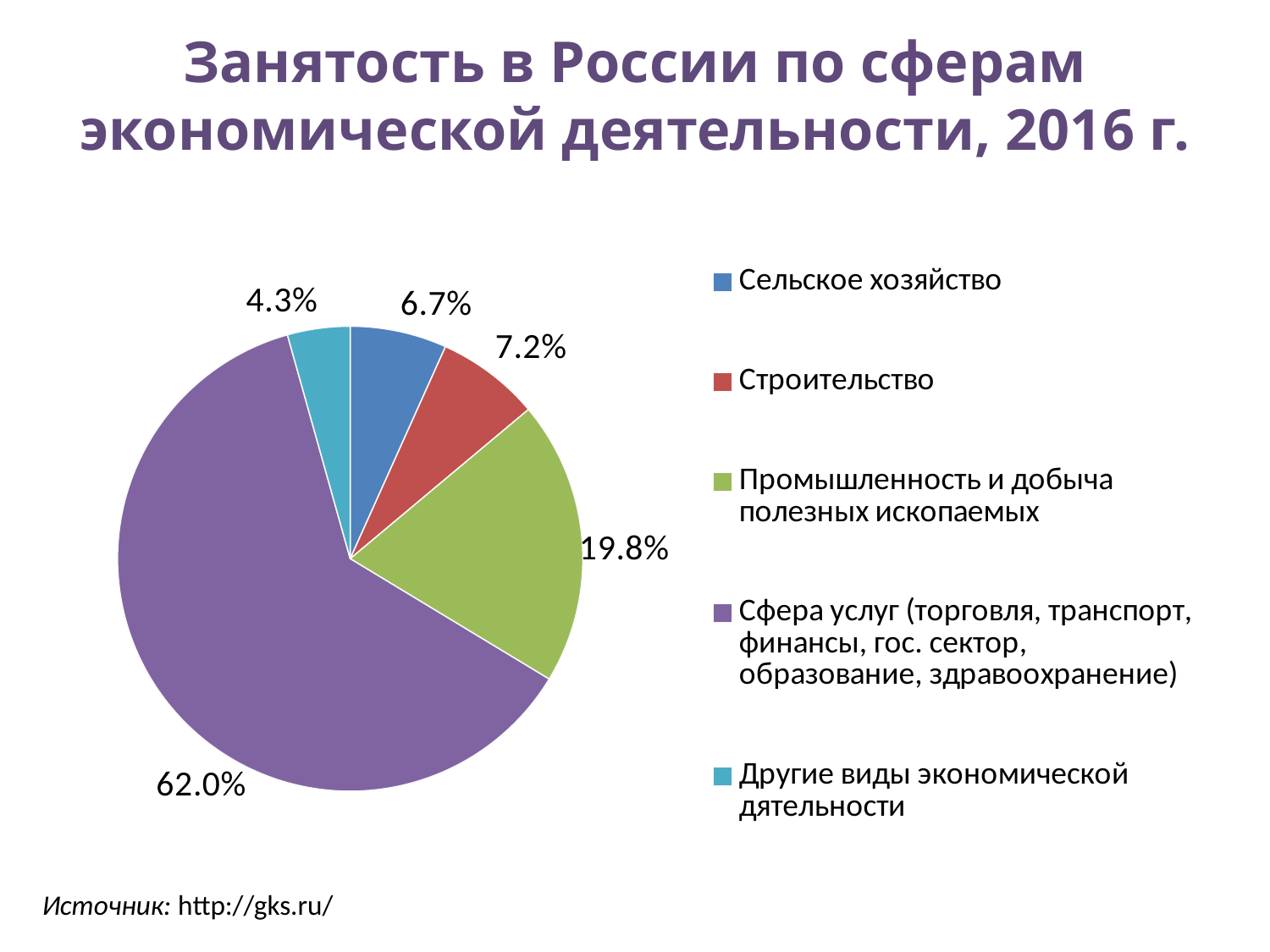
What is the difference in percentage points between Сфера услуг and Промышленность и добыча полезных ископаемых? 42.2 What share of employment does Строительство have? 7.2% What share of employment does Промышленность и добыча полезных ископаемых have? 19.8% How many sectors are shown in the pie chart? 5 What share of employment does Другие виды экономической дятельности have? 4.3% What share of employment does Сфера услуг have? 62.0% Which sector has the smallest share of employment? Другие виды экономической дятельности What is the title of the chart? Занятость в России по сферам экономической деятельности, 2016 г. Which has a larger share: Строительство or Сельское хозяйство? Строительство Which sector has the largest share of employment? Сфера услуг (торговля, транспорт, финансы, гос. сектор, образование, здравоохранение) What kind of chart is shown on the slide? pie chart What share of employment does Сельское хозяйство have? 6.7%